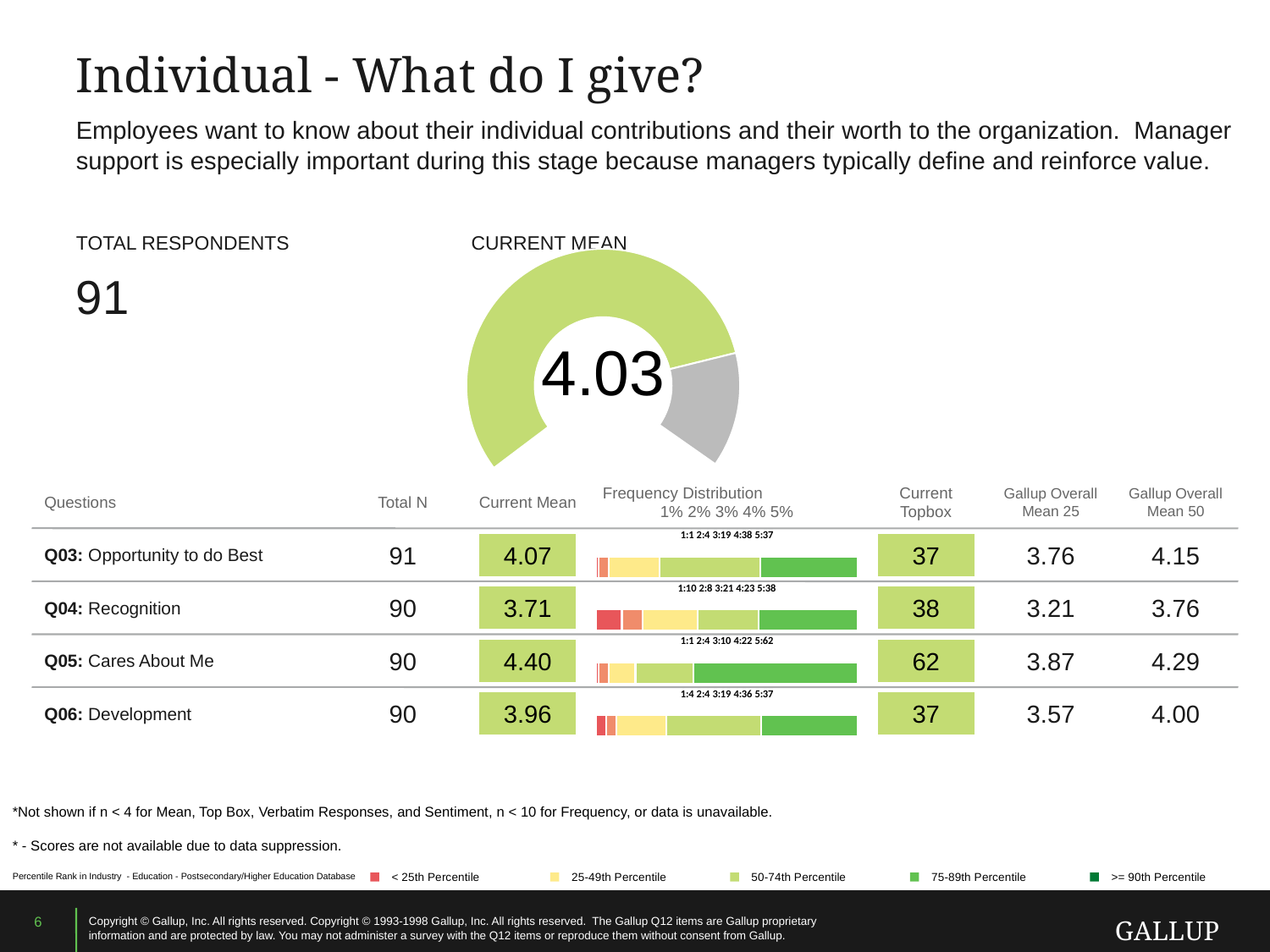
How many Frequency Distribution bars are shown in the table? 4 In the Frequency Distribution bar for Q05: Cares About Me, what is the value for rating 5? 62 What value does the CURRENT MEAN gauge chart show? 4.03 Across the Frequency Distribution bars, which question has the highest value for rating 5? Q05: Cares About Me In the Frequency Distribution bar for Q04: Recognition, what is the value for rating 1? 10 What is the total of all segments in the Frequency Distribution bar for Q04: Recognition? 100 In the Frequency Distribution bars, which is larger: the rating-4 value for Q04 or the rating-4 value for Q06? Q06 In the Frequency Distribution bar for Q03: Opportunity to do Best, what is the value for rating 5? 37 What is the title of the gauge chart on the slide? CURRENT MEAN In the Frequency Distribution bars, what is the difference between the rating-5 value for Q05 and the rating-5 value for Q03? 25 Across the Frequency Distribution bars, which question has the highest value for rating 1? Q04: Recognition What kind of chart is used for the Frequency Distribution column? Stacked bar chart